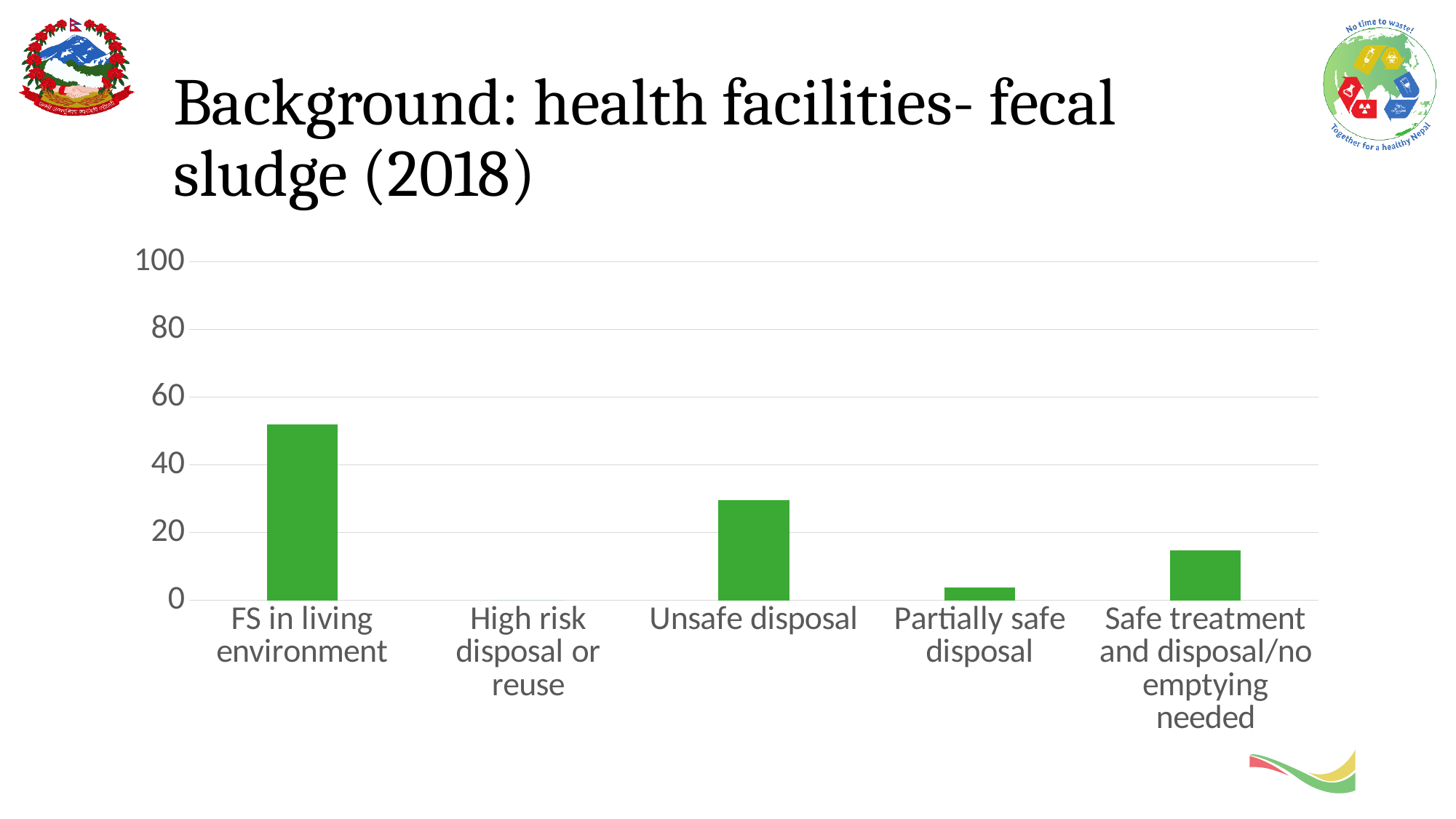
Is the value for Unsafe disposal greater or less than 20? greater Is the value for Safe treatment and disposal/no emptying needed greater or less than 20? less Which is larger, the value for Partially safe disposal or the value for Safe treatment and disposal/no emptying needed? Safe treatment and disposal/no emptying needed How many categories are shown on the x axis of the chart? 5 Is the value for Unsafe disposal greater or less than 40? less Which category has the lowest value in the chart? High risk disposal or reuse Which is larger, the value for Unsafe disposal or the value for Safe treatment and disposal/no emptying needed? Unsafe disposal What kind of chart is shown on the slide? bar chart Which category has the highest bar in the chart? FS in living environment What is the highest tick value shown on the vertical axis of the chart? 100